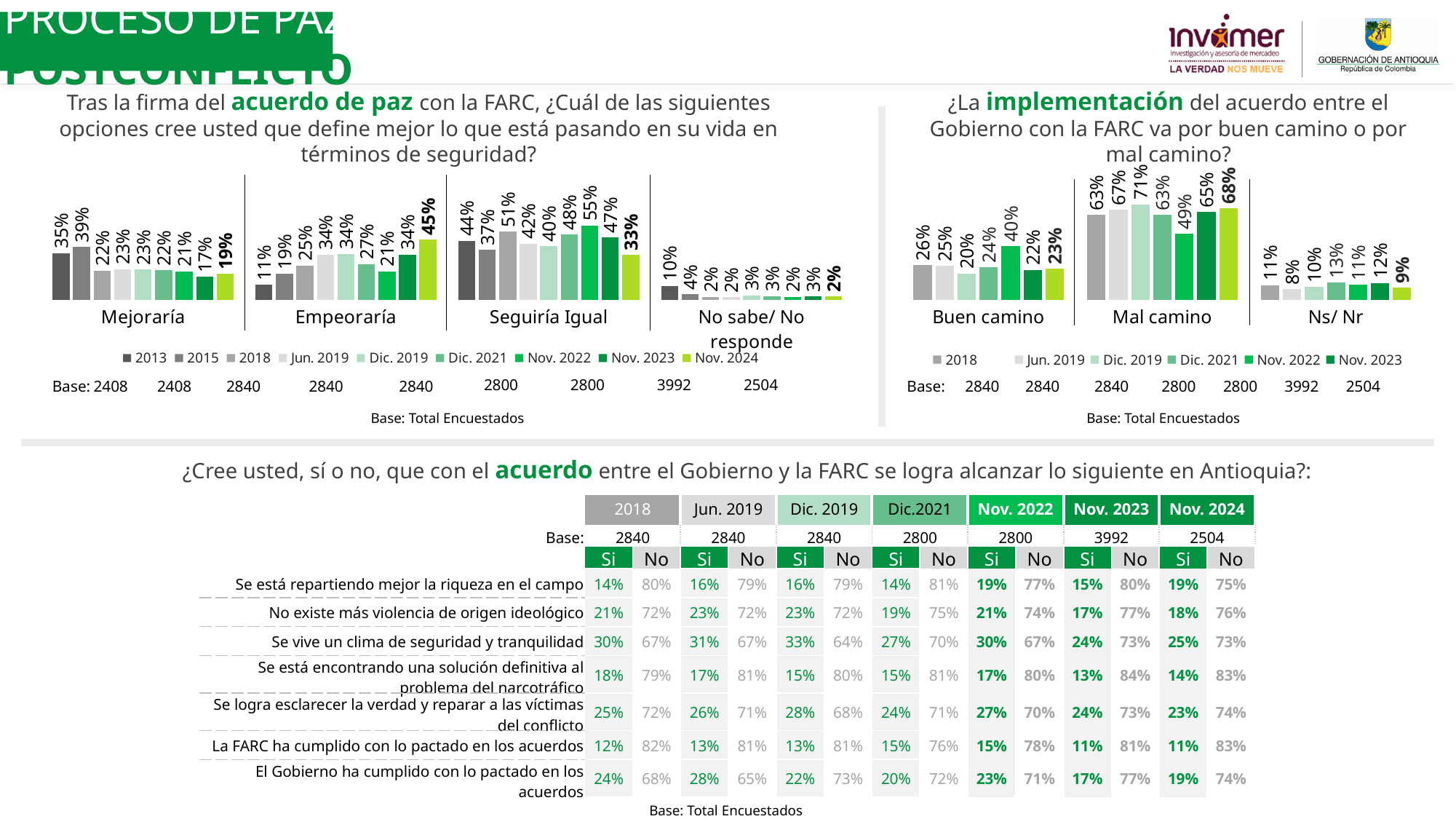
In the left chart (Tras la firma del acuerdo de paz), how many series does the legend list? 9 In the right chart (¿La implementación del acuerdo...), what is the difference between the Mal camino and Buen camino values for the last (Nov. 2024) bar? 45% In the right chart (¿La implementación del acuerdo...), is the Nov. 2022 value for Mal camino larger or smaller than the Dic. 2021 value? smaller What type of chart is used in the right chart (¿La implementación del acuerdo...)? bar chart In the left chart (Tras la firma del acuerdo de paz), how many response categories are shown? 4 In the left chart (Tras la firma del acuerdo de paz), what is the Nov. 2024 value for Empeoraría? 45% In the left chart (Tras la firma del acuerdo de paz), what is the difference between the Nov. 2024 and Nov. 2023 values for Empeoraría? 11% In the left chart (Tras la firma del acuerdo de paz), which series has the lowest value for Mejoraría? Nov. 2023 In the left chart (Tras la firma del acuerdo de paz), what is the 2013 value for Seguiría Igual? 44% In the right chart (¿La implementación del acuerdo...), what is the Nov. 2022 value for Buen camino? 40% In the right chart (¿La implementación del acuerdo...), which bar is highest for Mal camino? Dic. 2019 (71%) In the left chart (Tras la firma del acuerdo de paz), which series has the highest value for Seguiría Igual? Nov. 2022